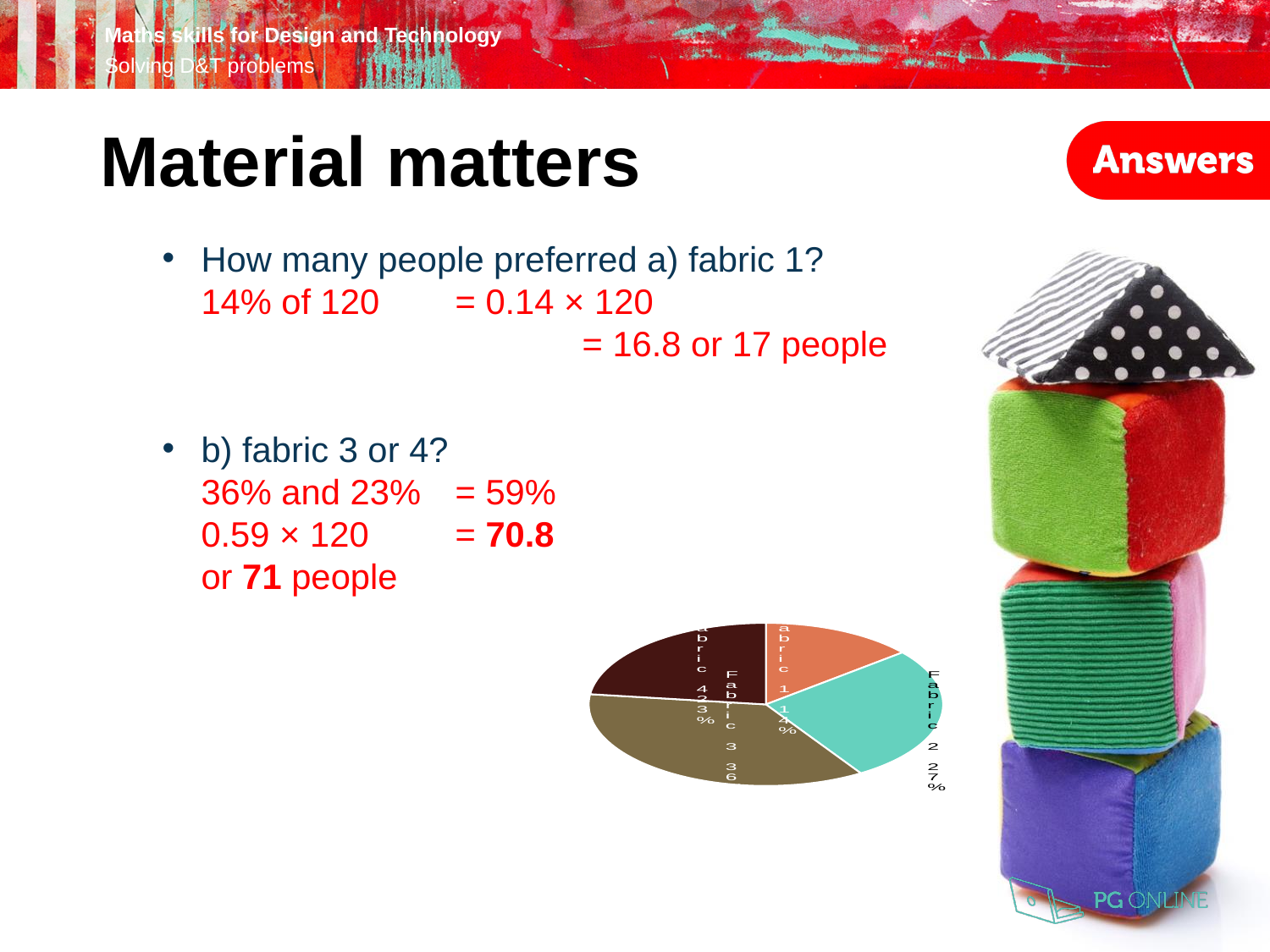
What percentage of the pie chart is Fabric 1? 14% Which fabric has the smallest slice of the pie chart? Fabric 1 Which has the larger share in the pie chart, Fabric 2 or Fabric 4? Fabric 2 By how many percentage points does Fabric 2's share exceed Fabric 1's share in the pie chart? 13 percentage points Which fabric has the largest slice of the pie chart? Fabric 3 What colour is the Fabric 2 slice in the pie chart? Teal What percentage of the pie chart is Fabric 4? 23% How many slices does the pie chart have? 4 What percentage of the pie chart is Fabric 2? 27% What share of the pie chart does Fabric 3 represent? 36% What kind of chart is shown on the slide? Pie chart What is the combined share of Fabric 3 and Fabric 4 in the pie chart? 59%